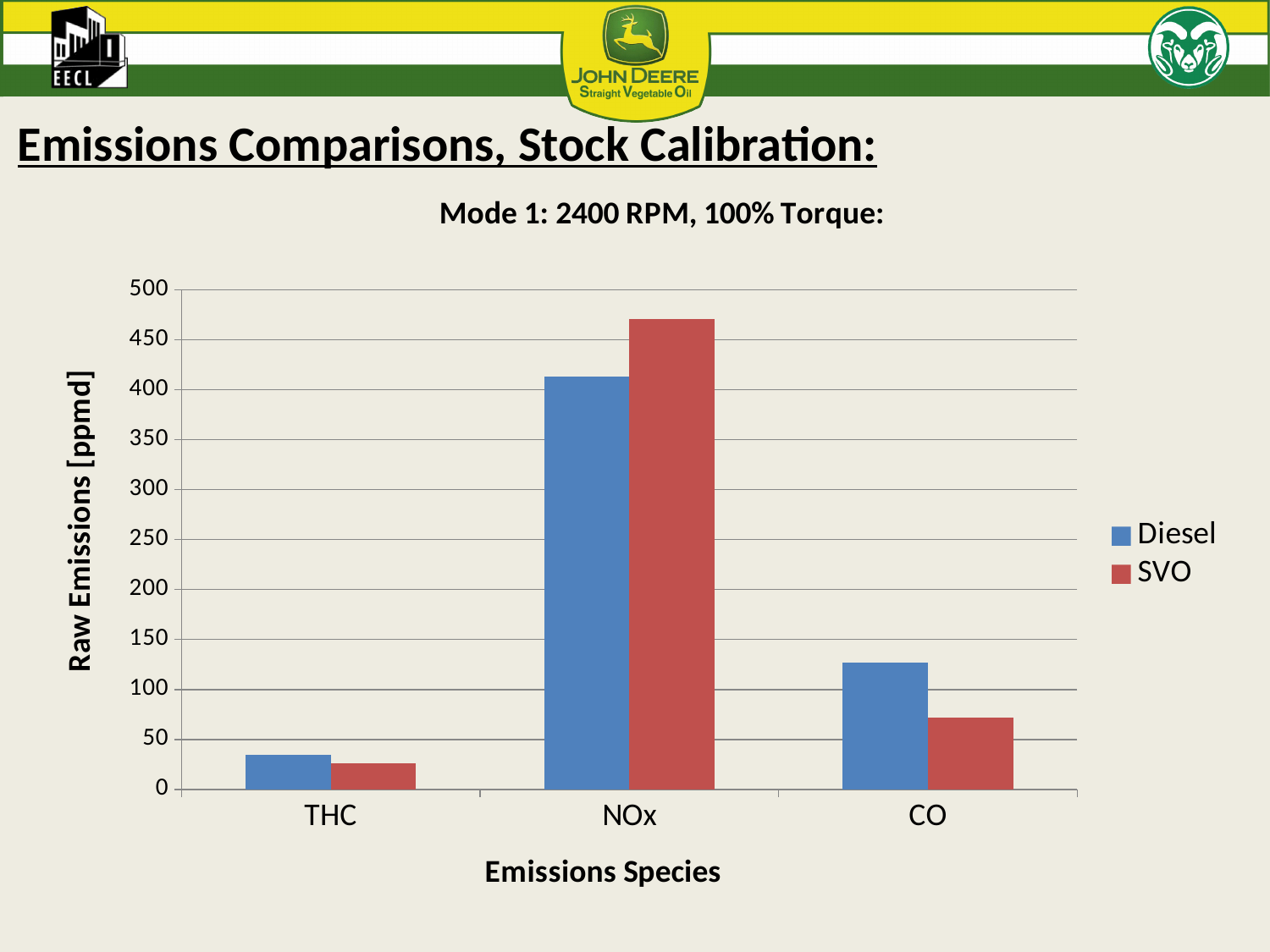
Which emissions species has the highest Diesel value? NOx What is the title of the chart? Mode 1: 2400 RPM, 100% Torque: How many emissions species categories are shown on the x axis? 3 Is the SVO value for NOx greater or less than 450? greater What kind of chart is shown on the slide? bar chart What is the label of the y axis? Raw Emissions [ppmd] How many series does the legend list? 2 For CO, which is larger, the Diesel value or the SVO value? Diesel Is the SVO value for CO greater or less than 100? less For NOx, which is larger, the Diesel value or the SVO value? SVO Is the Diesel value for CO greater or less than 100? greater Which emissions species has the lowest SVO value? THC